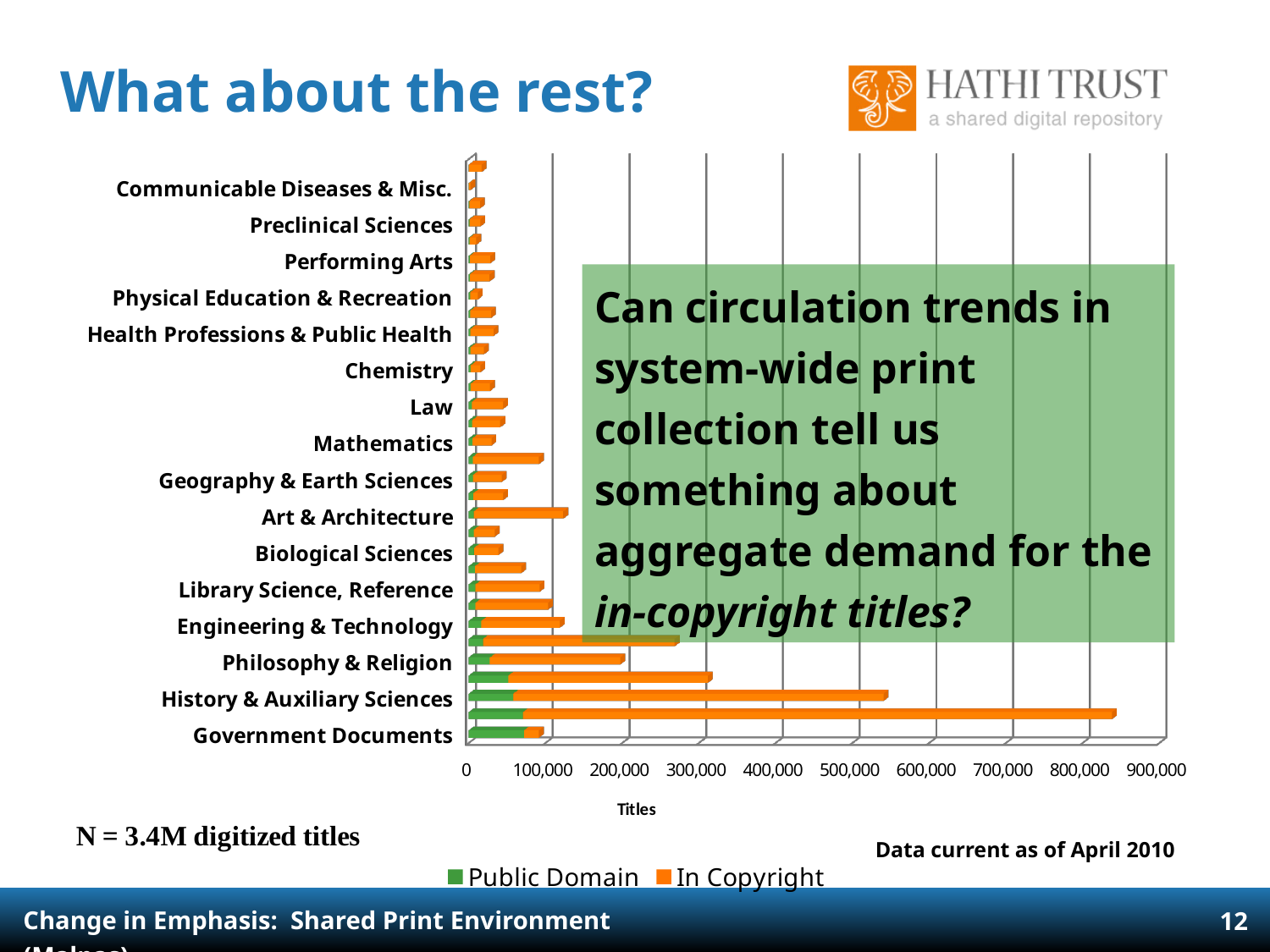
What is the title of the chart's horizontal axis? Titles Do the bar lengths generally increase or decrease going from the top of the chart to the bottom? increase Which series makes up the larger part of the bars, Public Domain or In Copyright? In Copyright What are the two series named in the chart's legend? Public Domain and In Copyright What kind of chart is shown on the slide? bar chart Which has the larger value, Government Documents or Communicable Diseases & Misc.? Government Documents Is the value for Communicable Diseases & Misc. greater or less than 100,000? less Which has the larger value, History & Auxiliary Sciences or Preclinical Sciences? History & Auxiliary Sciences Is the longest bar in the chart greater or less than 800,000? greater Is the value for Chemistry greater or less than 100,000? less How many series does the chart's legend list? 2